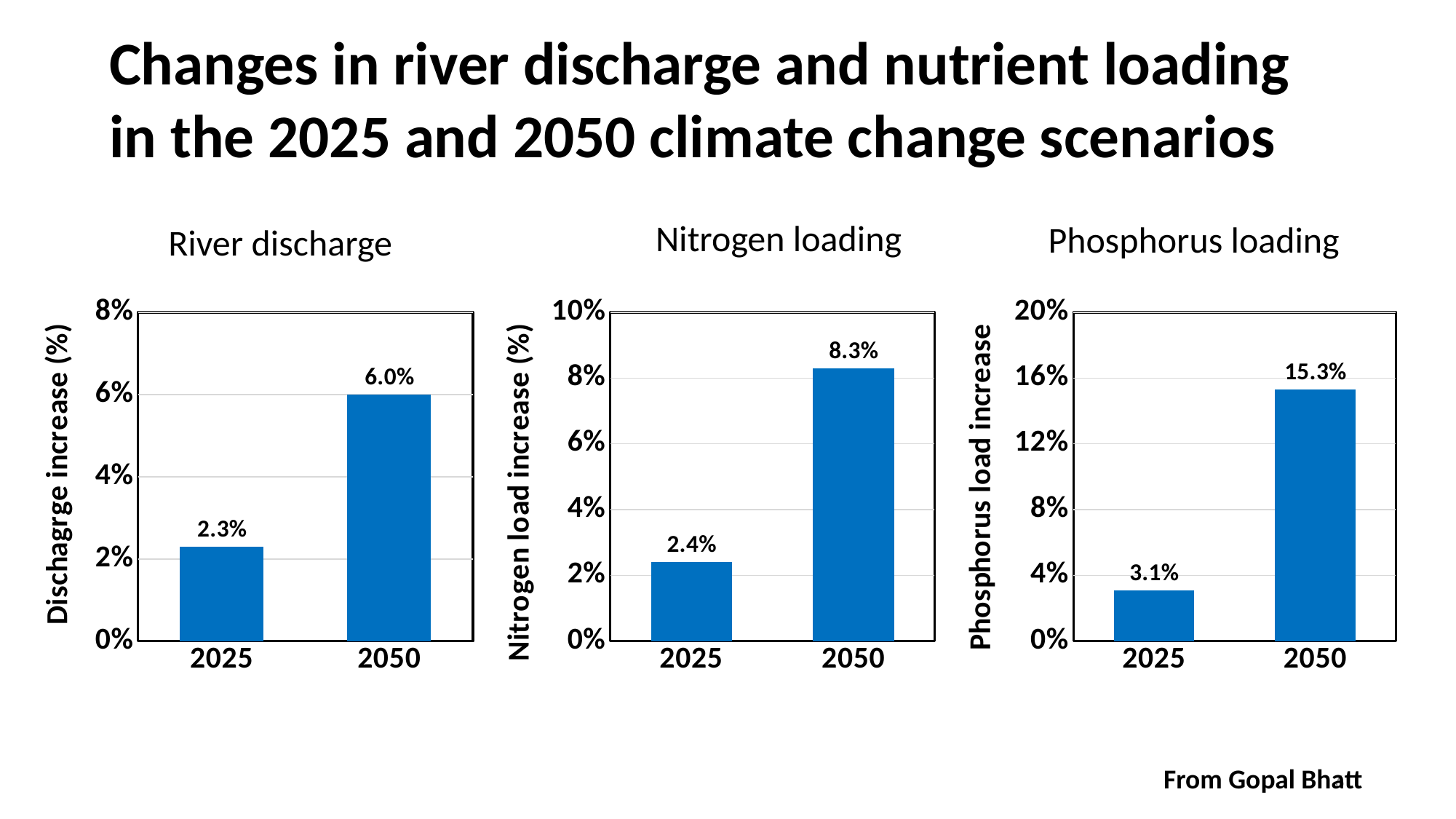
In the Nitrogen loading chart, what is the nitrogen load increase for 2025? 2.4% In the Phosphorus loading chart, which year has the highest value? 2050 In the River discharge chart, do the values rise or fall from 2025 to 2050? Rise In the River discharge chart, what is the discharge increase for 2050? 6.0% In the Nitrogen loading chart, what is the difference between the 2050 and 2025 values? 5.9% What kind of chart is the Phosphorus loading chart? Bar chart In the Phosphorus loading chart, what is the difference between the 2050 and 2025 values? 12.2% In the Nitrogen loading chart, which year has the lowest value? 2025 How many categories are shown on the x axis of the Nitrogen loading chart? 2 In the River discharge chart, is the value for 2050 greater or less than 4%? greater In the Phosphorus loading chart, what is the phosphorus load increase for 2050? 15.3% In the River discharge chart, what is the discharge increase for 2025? 2.3%